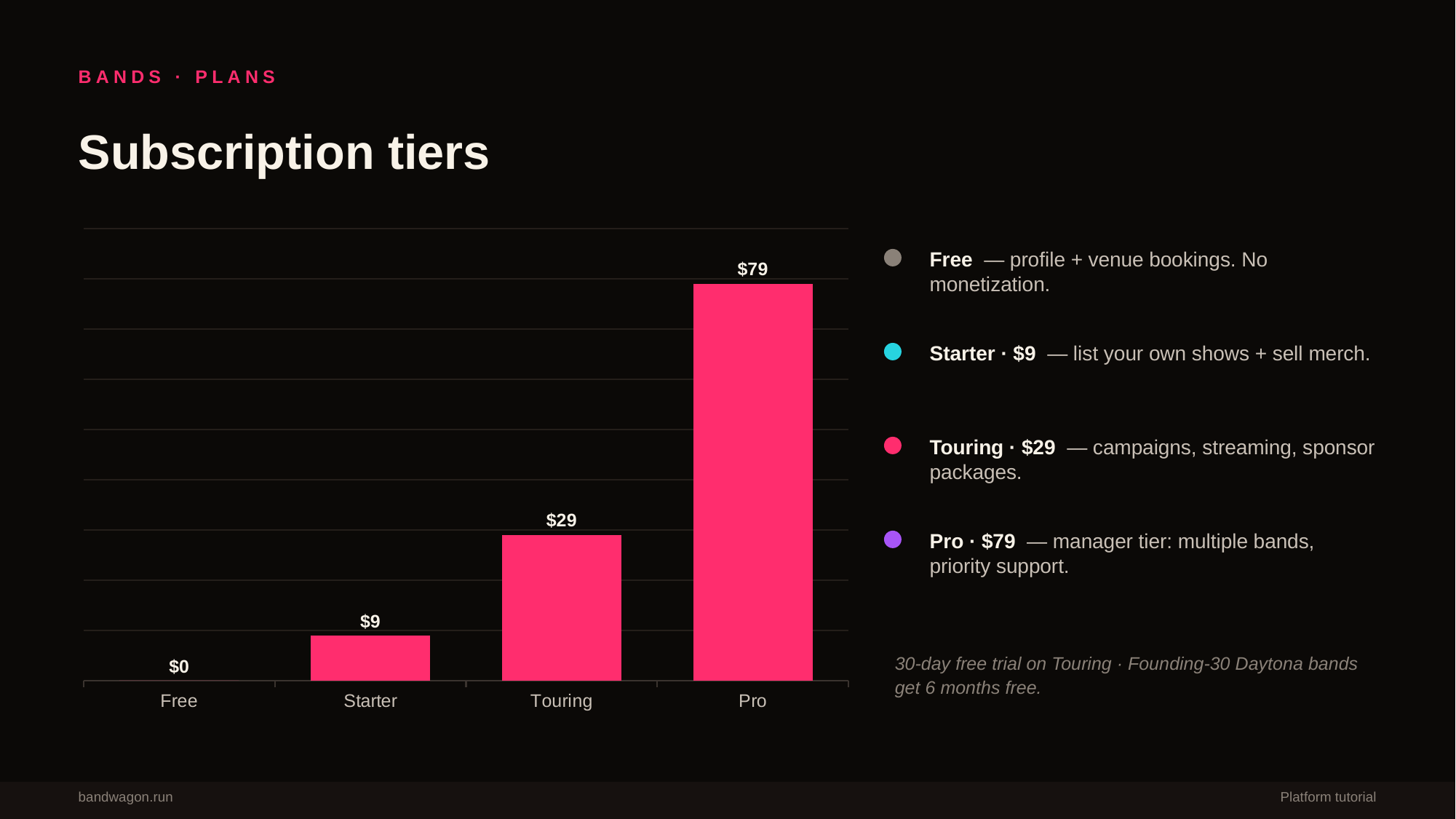
What is the value for the Pro tier? $79 What kind of chart is shown on the slide? Bar chart What is the value for the Free tier? $0 Which tier has the highest value? Pro What is the value for the Starter tier? $9 What is the value for the Touring tier? $29 Do the values rise or fall from Free to Pro along the x axis? Rise Which tier has the lowest value? Free How many tiers are shown on the chart? 4 What is the difference between the Touring and Starter values? $20 What is the difference between the Pro and Touring values? $50 Which is larger, the value for Starter or the value for Touring? Touring